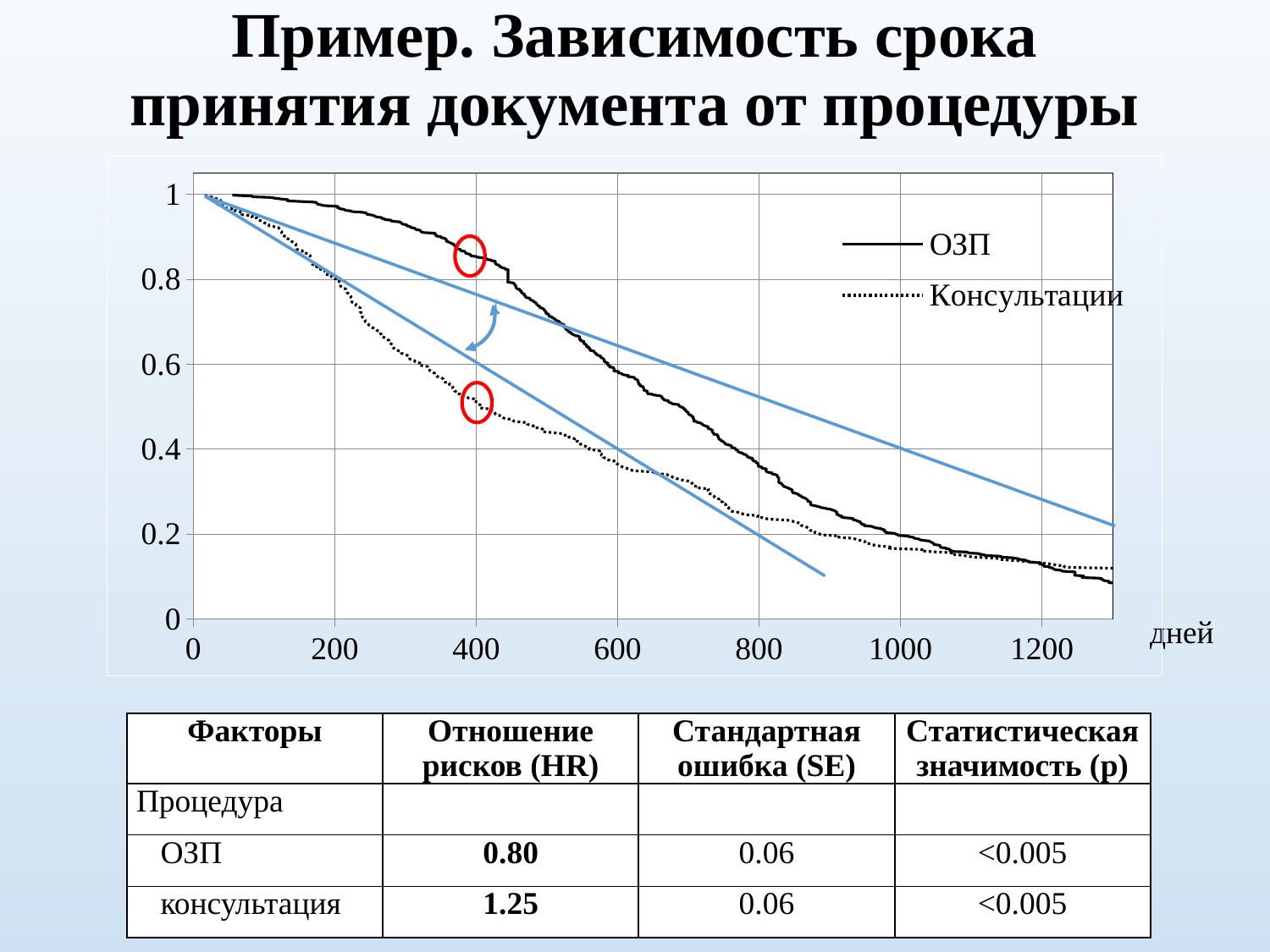
At 400 days, which series has the higher value, ОЗП or Консультации? ОЗП Do the values of the Консультации series rise or fall along the x axis? fall What kind of chart is shown on the slide? line chart Do the values of the ОЗП series rise or fall as the number of days increases? fall Is the value of the ОЗП series at 200 days greater or less than 0.8? greater Which series is drawn with a dotted line? Консультации Is the value of the Консультации series at 800 days greater or less than 0.4? less Is the value of the ОЗП series at 400 days greater or less than 0.8? greater At 600 days, which series has the higher value, ОЗП or Консультации? ОЗП Which two series are listed in the chart legend? ОЗП and Консультации How many series does the chart legend list? 2